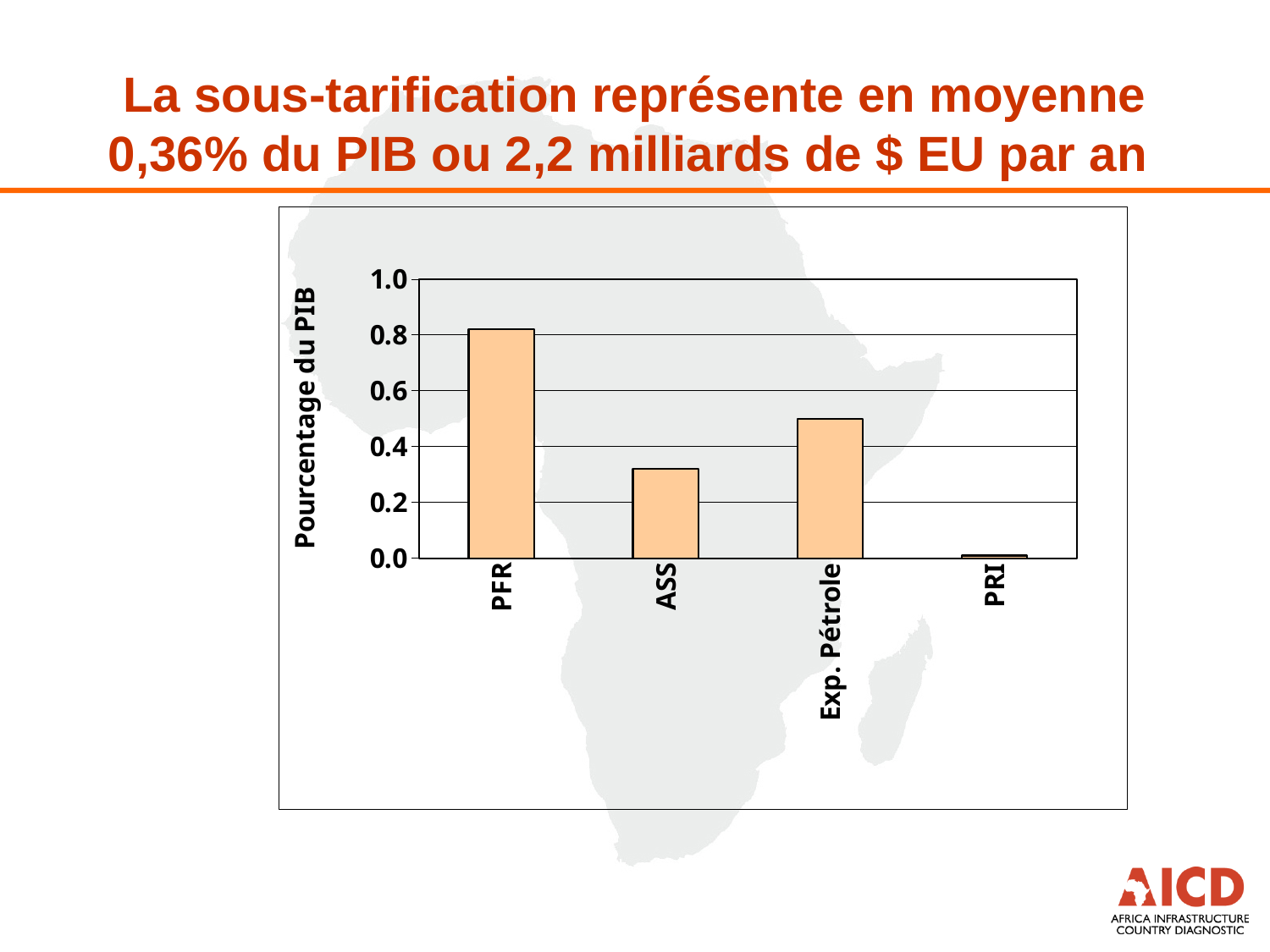
Which is larger, the value for ASS or the value for Exp. Pétrole? Exp. Pétrole What is the label of the vertical axis? Pourcentage du PIB Is the value for PFR greater or less than 0.8? greater What kind of chart is shown on the slide? bar chart How many categories are plotted on the chart? 4 Which category has the highest value? PFR What is the highest value shown on the vertical axis? 1.0 Is the value for ASS greater or less than 0.4? less Is the value for Exp. Pétrole greater or less than 0.4? greater Which category has the lowest value? PRI Which is larger, the value for PFR or the value for ASS? PFR